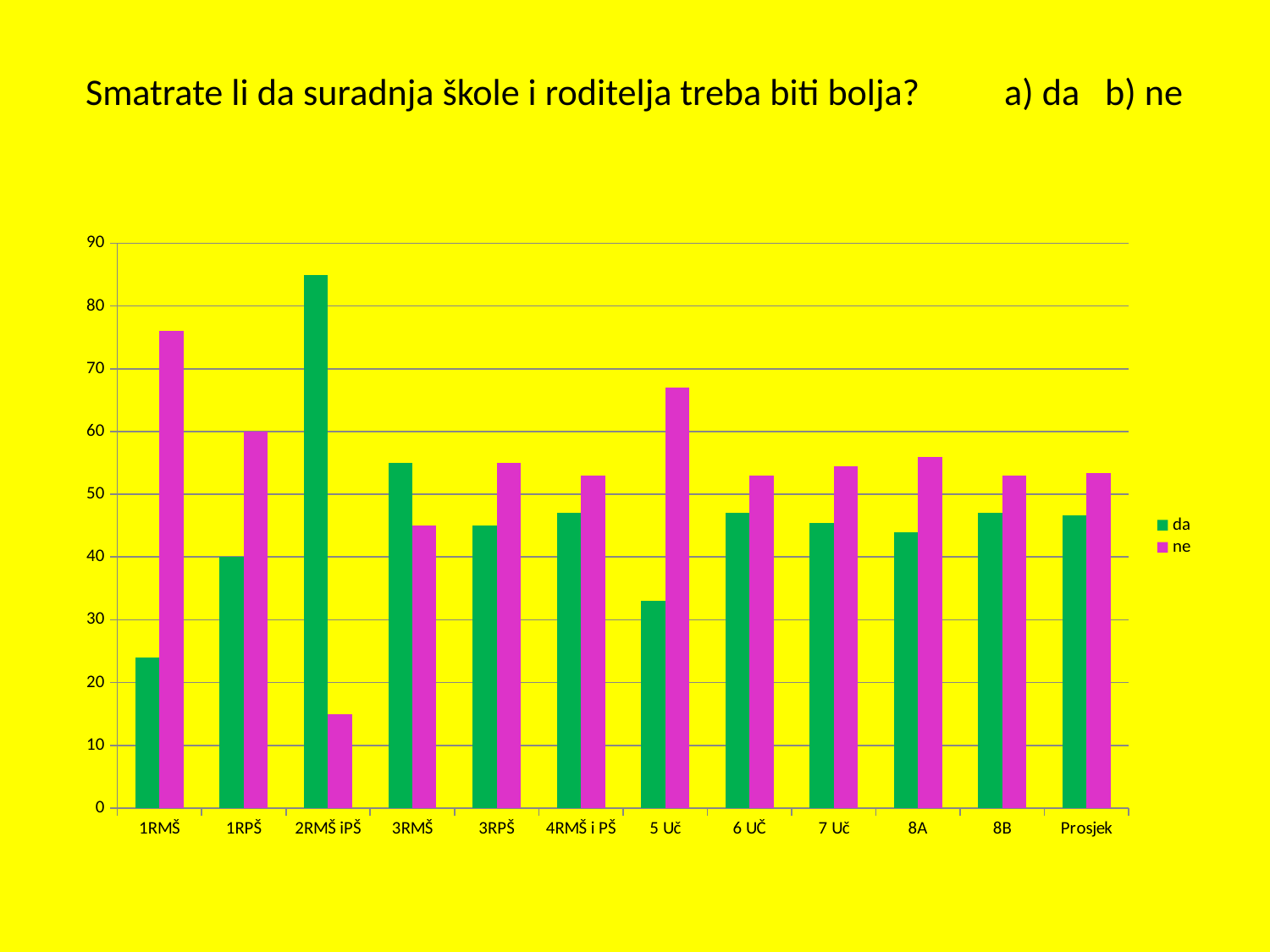
Which category has the lowest value for the "da" series? 1RMŠ Is the "da" value for 2RMŠ iPŠ greater or less than 80? greater What kind of chart is shown on the slide? bar chart Is the "ne" value for 2RMŠ iPŠ greater or less than 20? less For 1RMŠ, which is larger, the "da" value or the "ne" value? ne Which category has the lowest value for the "ne" series? 2RMŠ iPŠ Which colour represents the "ne" series in the legend? magenta How many categories are shown along the x axis? 12 Which category has the highest value for the "da" series? 2RMŠ iPŠ How many series does the legend list? 2 Is the "ne" value for 5 Uč greater or less than 60? greater Which category has the highest value for the "ne" series? 1RMŠ